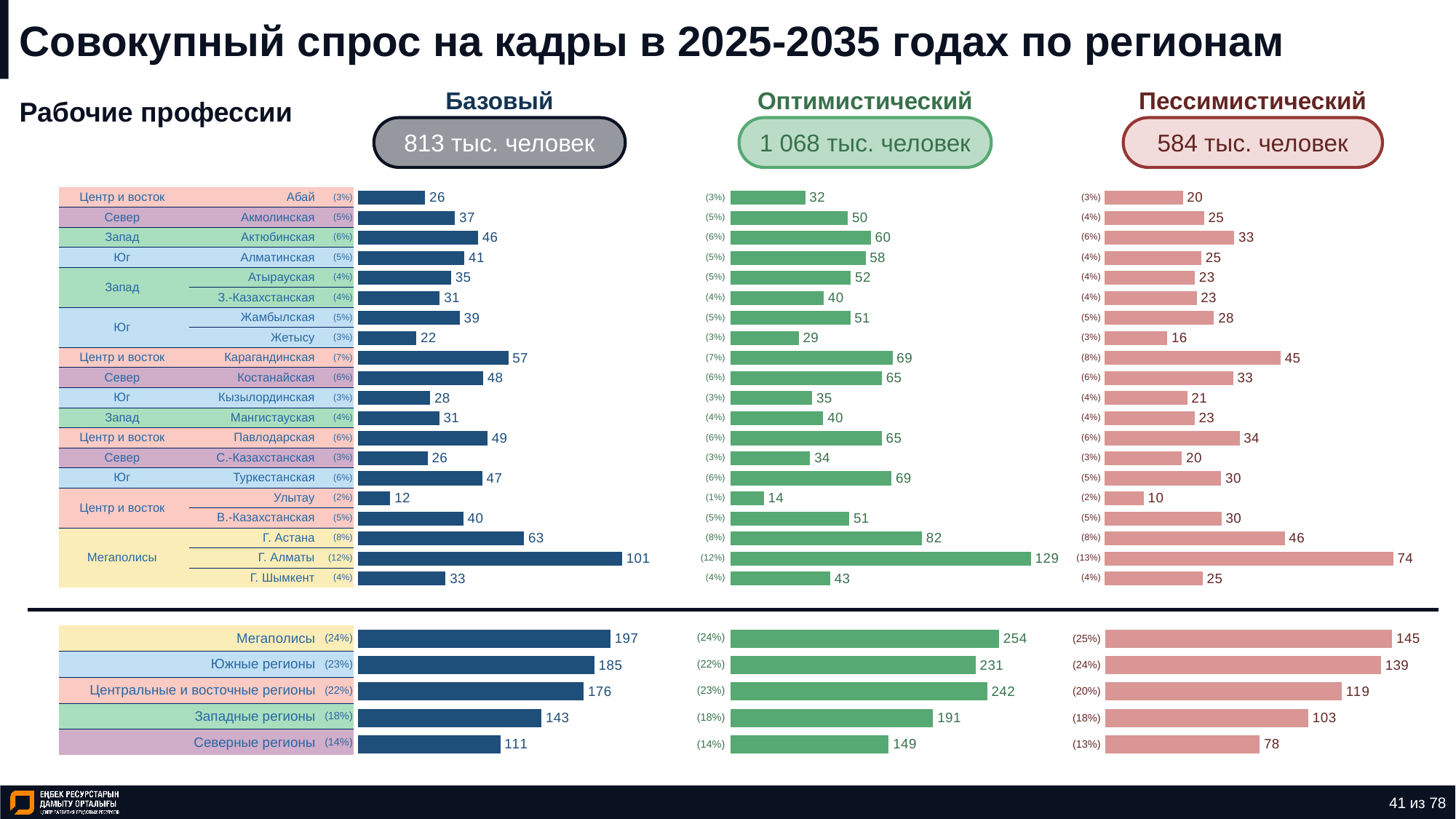
On the Пессимистический chart, which region in the upper section has the lowest value? Улытау What total is shown for the Оптимистический scenario? 1 068 тыс. человек On the Базовый chart, what percentage is shown next to Г. Алматы? 12% On the Оптимистический chart, what is the difference between the values for Мегаполисы and Северные регионы in the lower section? 105 On the Оптимистический chart, which region in the upper section has the highest value? Г. Алматы On the Базовый chart, what is the value for Г. Алматы? 101 On the Базовый chart, what is the difference between the values for Г. Астана and Г. Шымкент? 30 On the Пессимистический chart, what is the value for Мегаполисы in the lower section? 145 How many regions are listed in the upper section of the Базовый chart? 20 On the Базовый chart, what is the value for Западные регионы? 143 On the Оптимистический chart, which is larger: the value for Карагандинская or for Костанайская? Карагандинская What type of chart is used on this slide? Bar chart